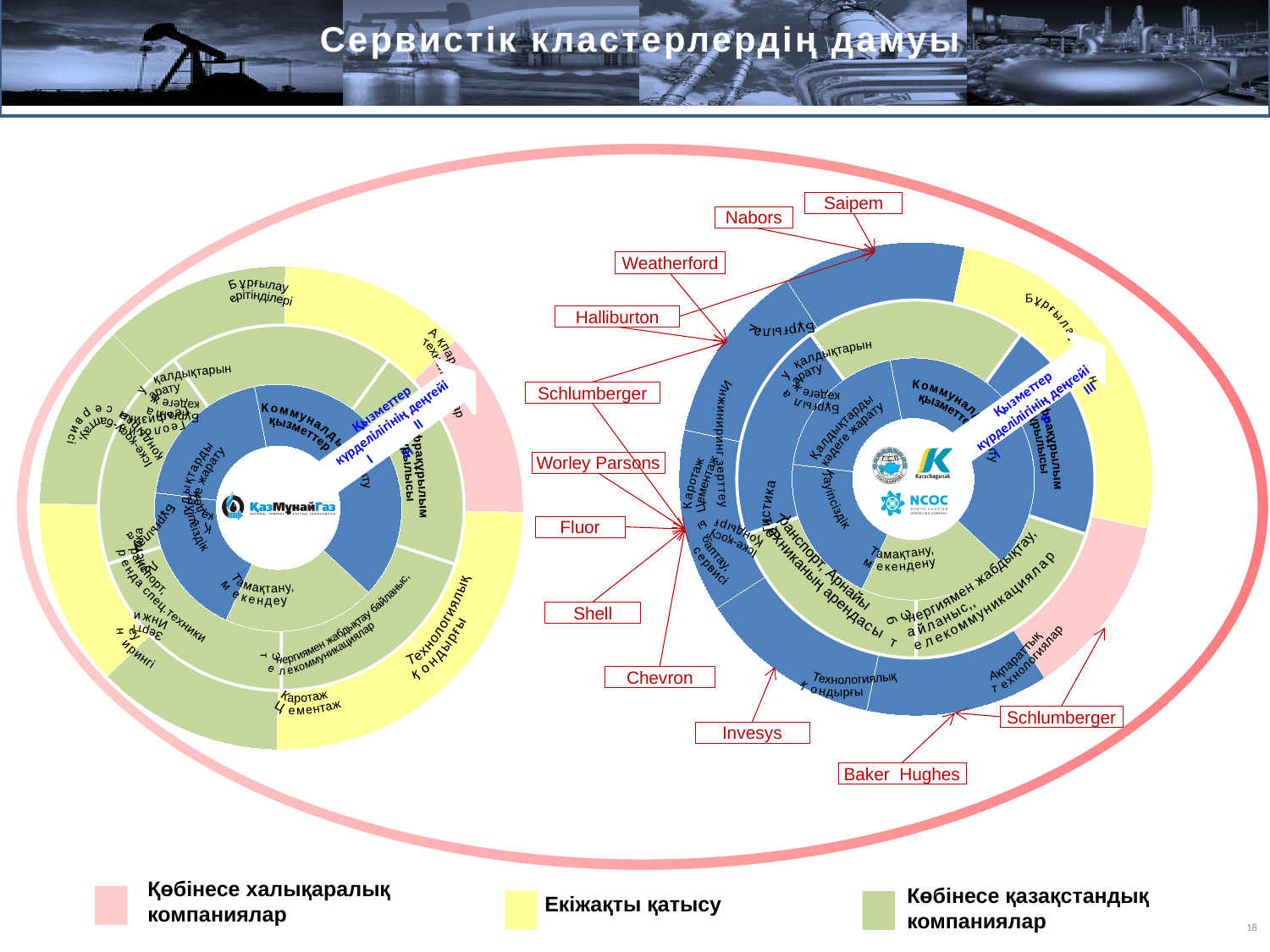
How many company name labels point to the right-hand ring diagram? 12 What kind of chart is used on this slide? Doughnut (ring) chart Which company name appears twice among the labels pointing to the right-hand diagram? Schlumberger Which company logo is shown at the centre of the left-hand ring diagram? ҚазМұнайГаз How many ring diagrams are shown on the slide? 2 How many categories does the legend at the bottom of the slide list? 3 According to the legend, what does the pink colour represent? Көбінесе халықаралық компаниялар According to the legend, what does the yellow colour represent? Екіжақты қатысу